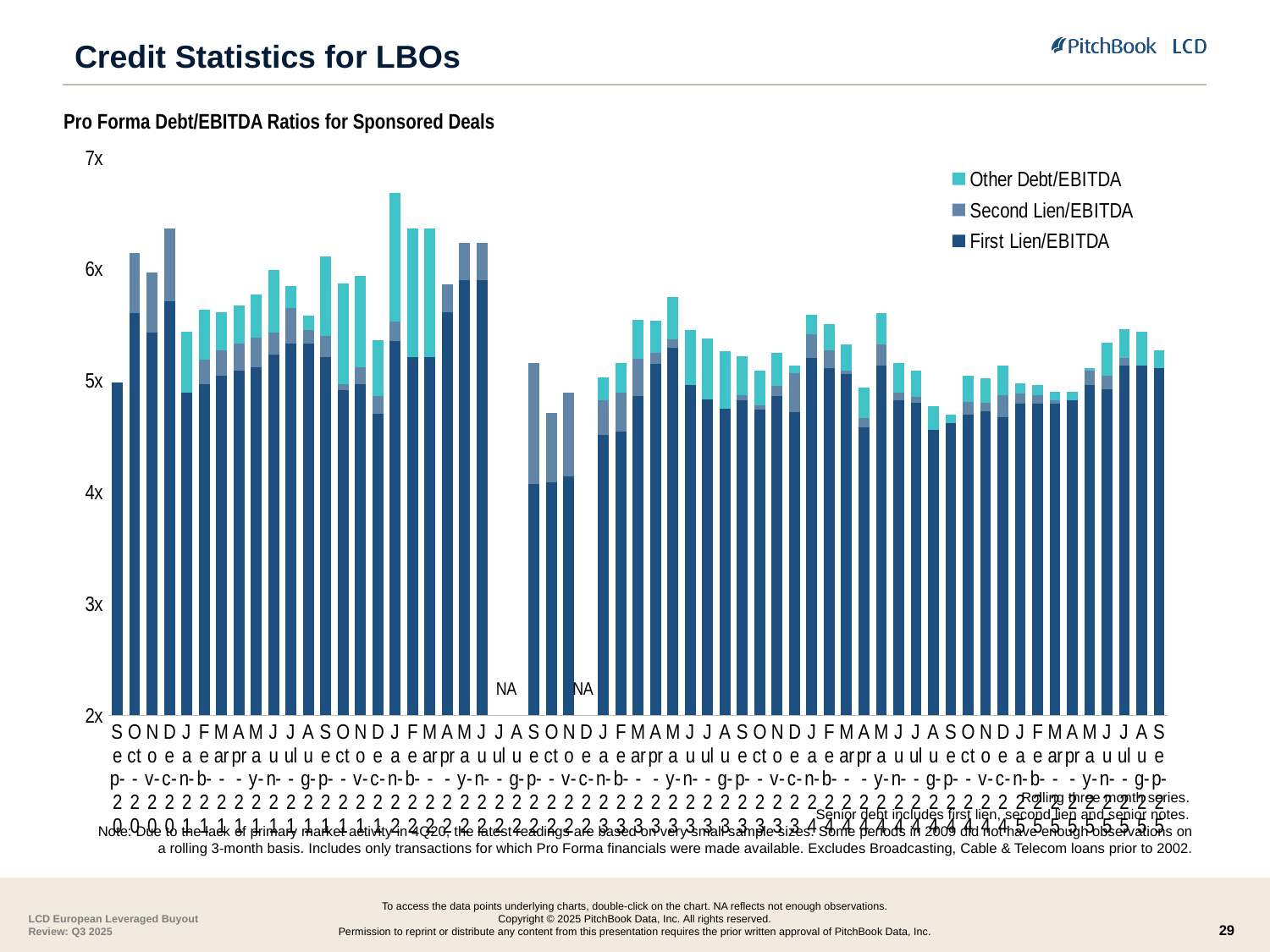
Is the First Lien/EBITDA value for the first bar on the left greater or less than 4x? greater Is the total of the last bar on the right greater or less than 5x? greater Which series is shown in the teal (light green-blue) colour? Other Debt/EBITDA Is the total of the tallest stacked bar greater or less than 6x? greater What is the title of the chart? Pro Forma Debt/EBITDA Ratios for Sponsored Deals How many series does the legend list? 3 Which series forms the bottom segment of each stacked bar? First Lien/EBITDA How many periods on the chart are marked NA? 2 What kind of chart is shown on the slide? Stacked bar chart